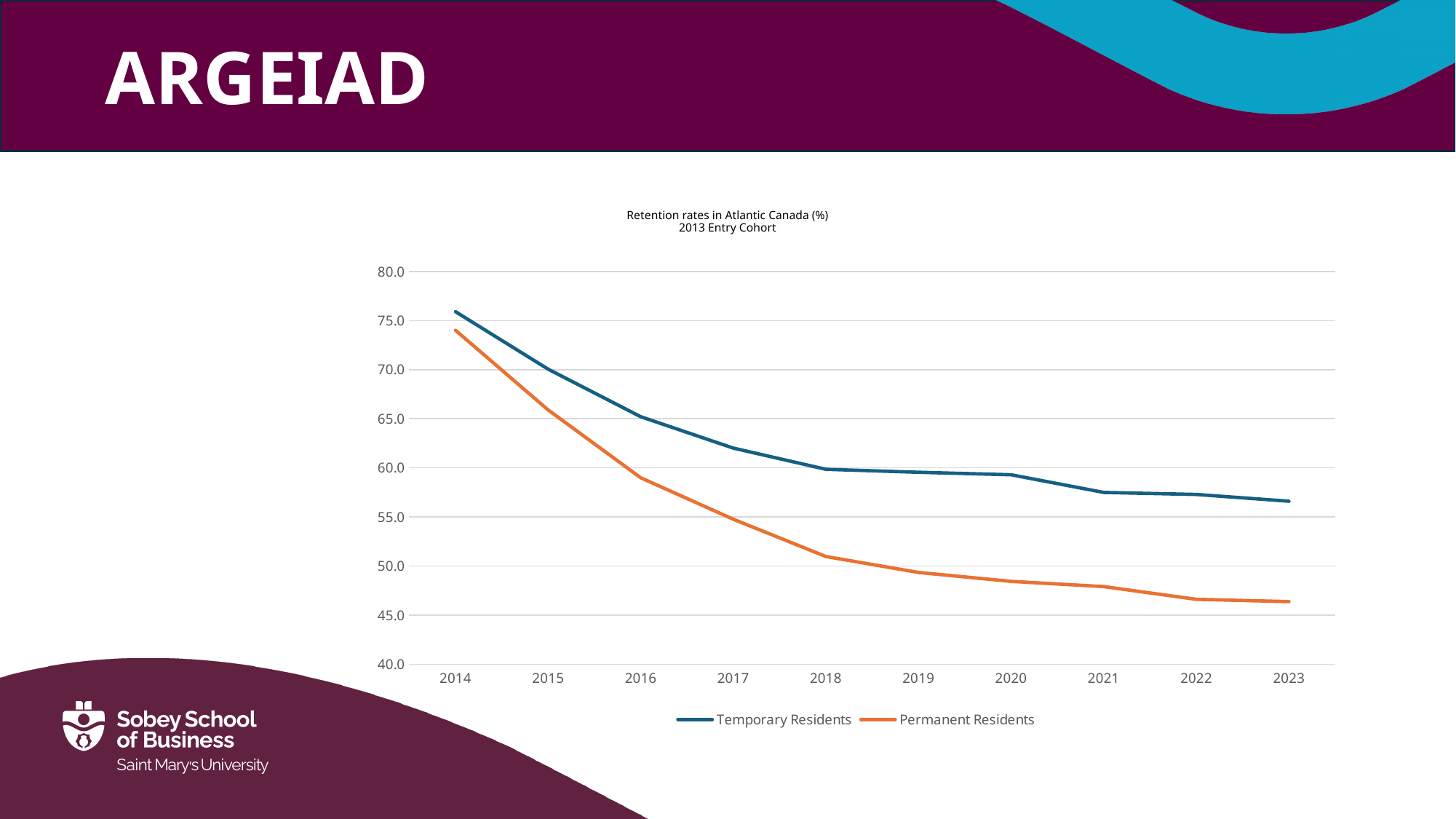
Which series has the higher retention rate in 2020, Temporary Residents or Permanent Residents? Temporary Residents What is the title of the chart? Retention rates in Atlantic Canada (%) 2013 Entry Cohort Is the retention rate for Permanent Residents in 2018 greater or less than 55.0? less How many series does the legend list? 2 Do the retention rates for Temporary Residents rise or fall from 2014 to 2023? fall Is the retention rate for Permanent Residents in 2023 greater or less than 50.0? less Is the retention rate for Temporary Residents in 2014 greater or less than 70.0? greater How many years are plotted along the x axis? 10 Do the retention rates for Permanent Residents rise or fall from 2014 to 2023? fall What kind of chart is shown on the slide? line chart In which year is the retention rate for Permanent Residents highest? 2014 In which year is the retention rate for Temporary Residents highest? 2014